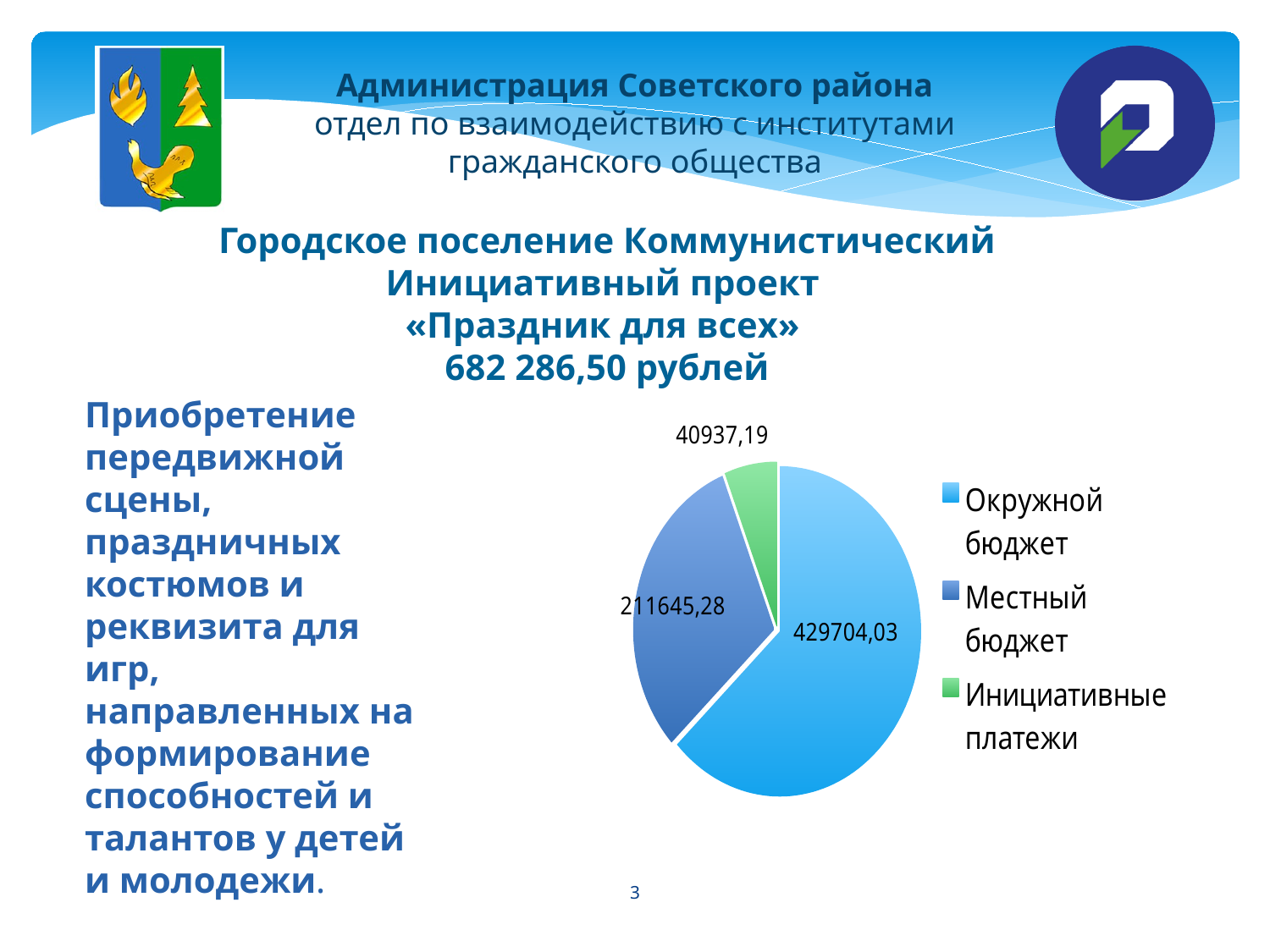
Which category has the largest slice in the pie chart? Окружной бюджет What is the value for Местный бюджет in the pie chart? 211645,28 What is the value for Инициативные платежи in the pie chart? 40937,19 What kind of chart is shown on the slide? pie chart What is the difference between the values for Окружной бюджет and Местный бюджет? 218058,75 What is the total of all three slices in the pie chart? 682286,50 How many slices does the pie chart have? 3 How many entries does the legend of the pie chart list? 3 What is the value for Окружной бюджет in the pie chart? 429704,03 Which category has the smallest slice in the pie chart? Инициативные платежи Which is larger: Местный бюджет or Инициативные платежи? Местный бюджет What is the difference between the values for Местный бюджет and Инициативные платежи? 170708,09